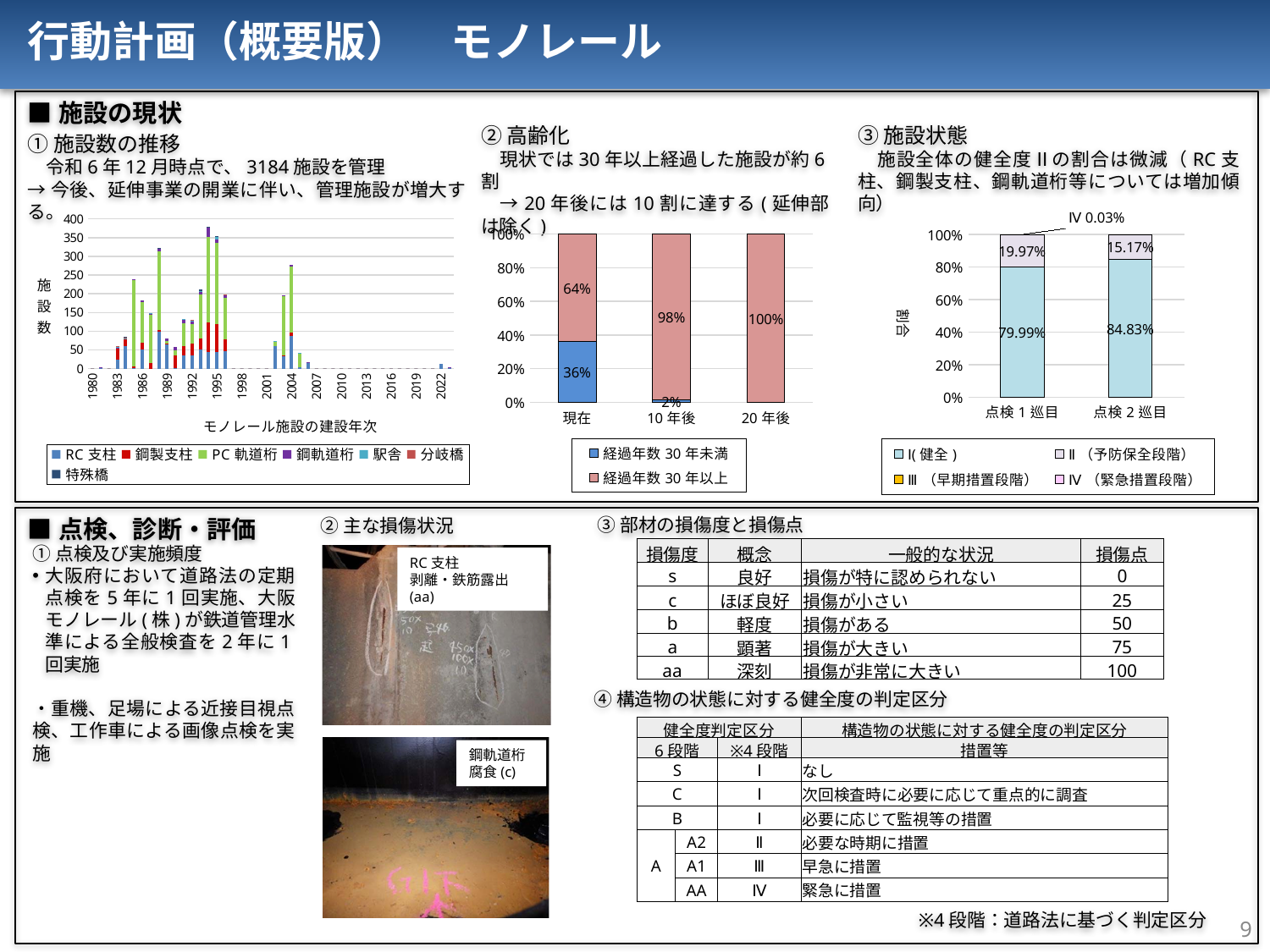
In the 施設状態 chart (right), which is larger, the Ⅰ(健全) value for 点検1巡目 or for 点検2巡目? 点検2巡目 In the 施設状態 chart (right), what is the difference between the Ⅱ(予防保全段階) values for 点検1巡目 and 点検2巡目? 4.80% In the 高齢化 chart (middle), how many categories are shown on the x axis? 3 In the 高齢化 chart (middle), what is the value of 経過年数30年以上 for 現在? 64% In the 高齢化 chart (middle), does the share of 経過年数30年以上 rise or fall from 現在 to 20年後? rise In the 高齢化 chart (middle), what is the value of 経過年数30年以上 for 20年後? 100% In the chart titled モノレール施設の建設年次, is the total value for 1994 greater or less than 300? greater In the chart titled モノレール施設の建設年次, what is the label of the vertical axis? 施設数 In the 施設状態 chart (right), what is the value of Ⅰ(健全) for 点検2巡目? 84.83% In the chart titled モノレール施設の建設年次, how many series does the legend list? 7 In the chart titled モノレール施設の建設年次, what kind of chart is it? bar chart In the 高齢化 chart (middle), what is the value of 経過年数30年未満 for 10年後? 2%